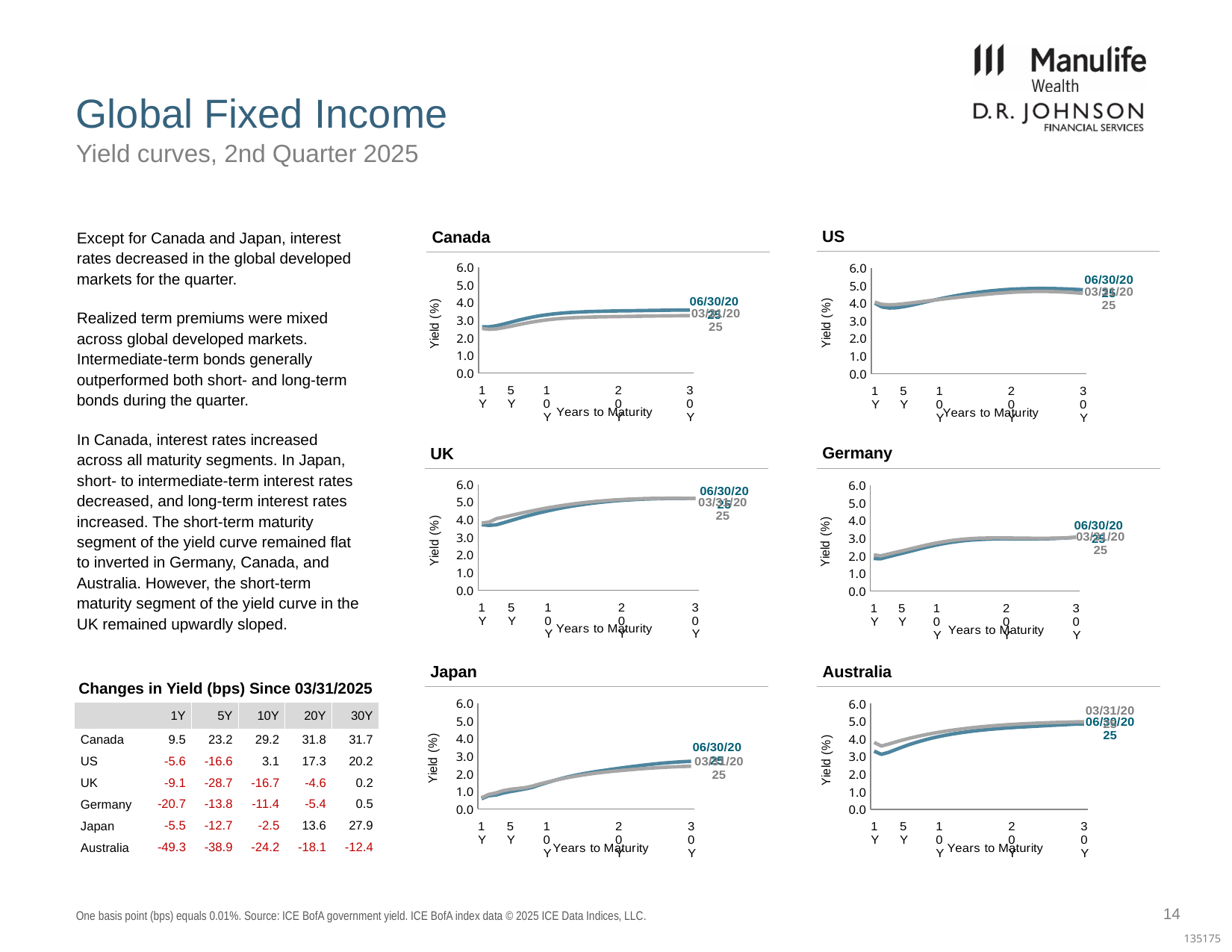
In the Australia chart, which series is higher at 1Y, 06/30/2025 or 03/31/2025? 03/31/2025 In the US chart, is the 06/30/2025 value at 1Y greater or less than 3.0? greater In the Canada chart, is the 06/30/2025 value at 30Y greater or less than 3.0? greater What kind of chart is the Canada chart? line chart In the Germany chart, is the 06/30/2025 value at 1Y greater or less than 3.0? less How many maturity points are plotted along the x axis of the Japan chart? 5 How many yield curve charts are shown on the slide? 6 In the Japan chart, do the 06/30/2025 values rise or fall as years to maturity increase? rise What is the x-axis title of the Germany chart? Years to Maturity